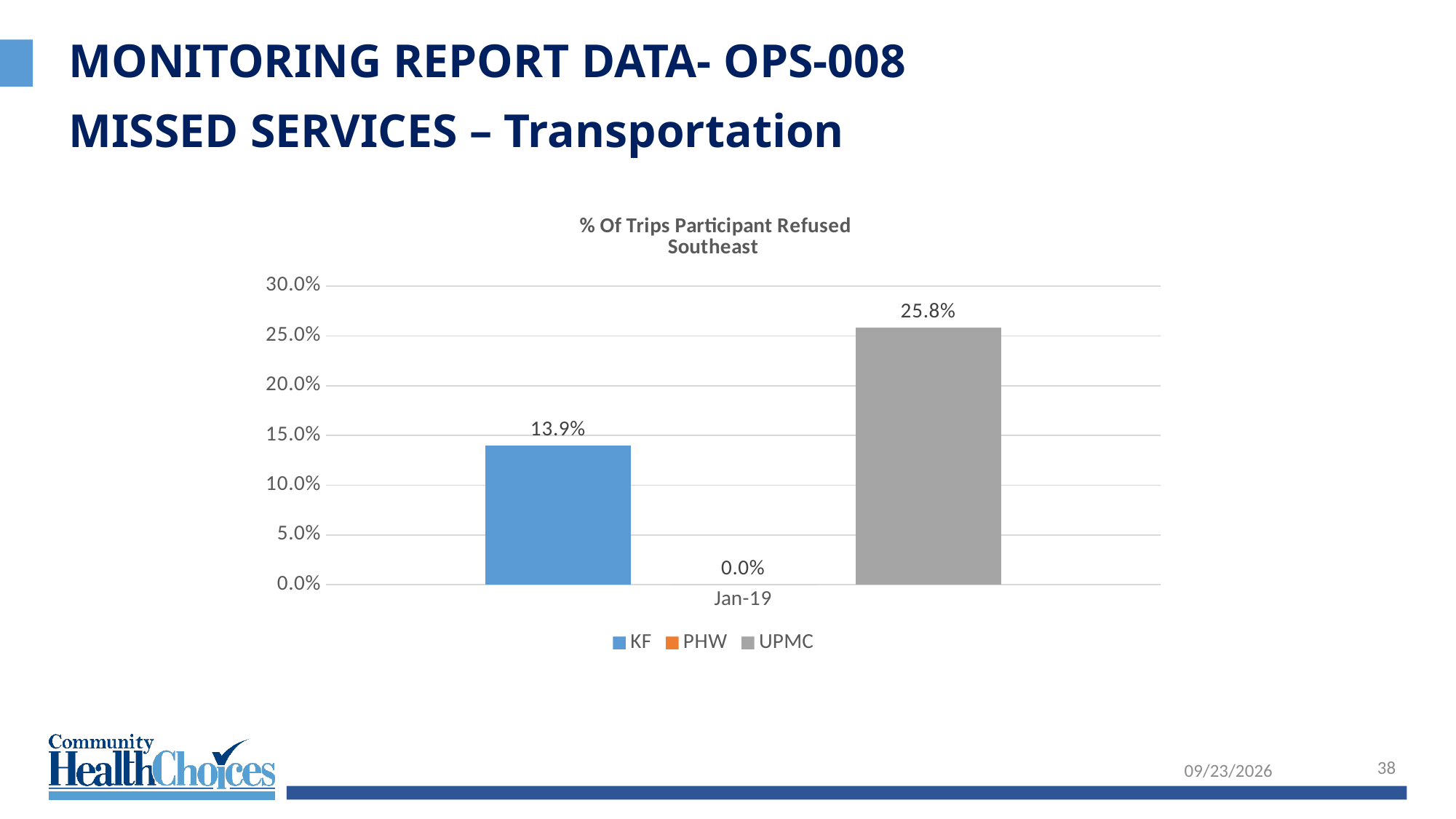
Which series has the highest value in Jan-19? UPMC Which series has the lowest value in Jan-19? PHW What is the title of the chart? % Of Trips Participant Refused Southeast What is the value for KF in Jan-19? 13.9% What kind of chart is shown on the slide? bar chart Which is larger in Jan-19, the value for KF or the value for UPMC? UPMC What is the value for UPMC in Jan-19? 25.8% What is the difference between the UPMC and KF values in Jan-19? 11.9% How many series does the legend list? 3 Is the value for UPMC greater or less than 20.0%? greater What is the value for PHW in Jan-19? 0.0% What colour is the bar for UPMC? gray